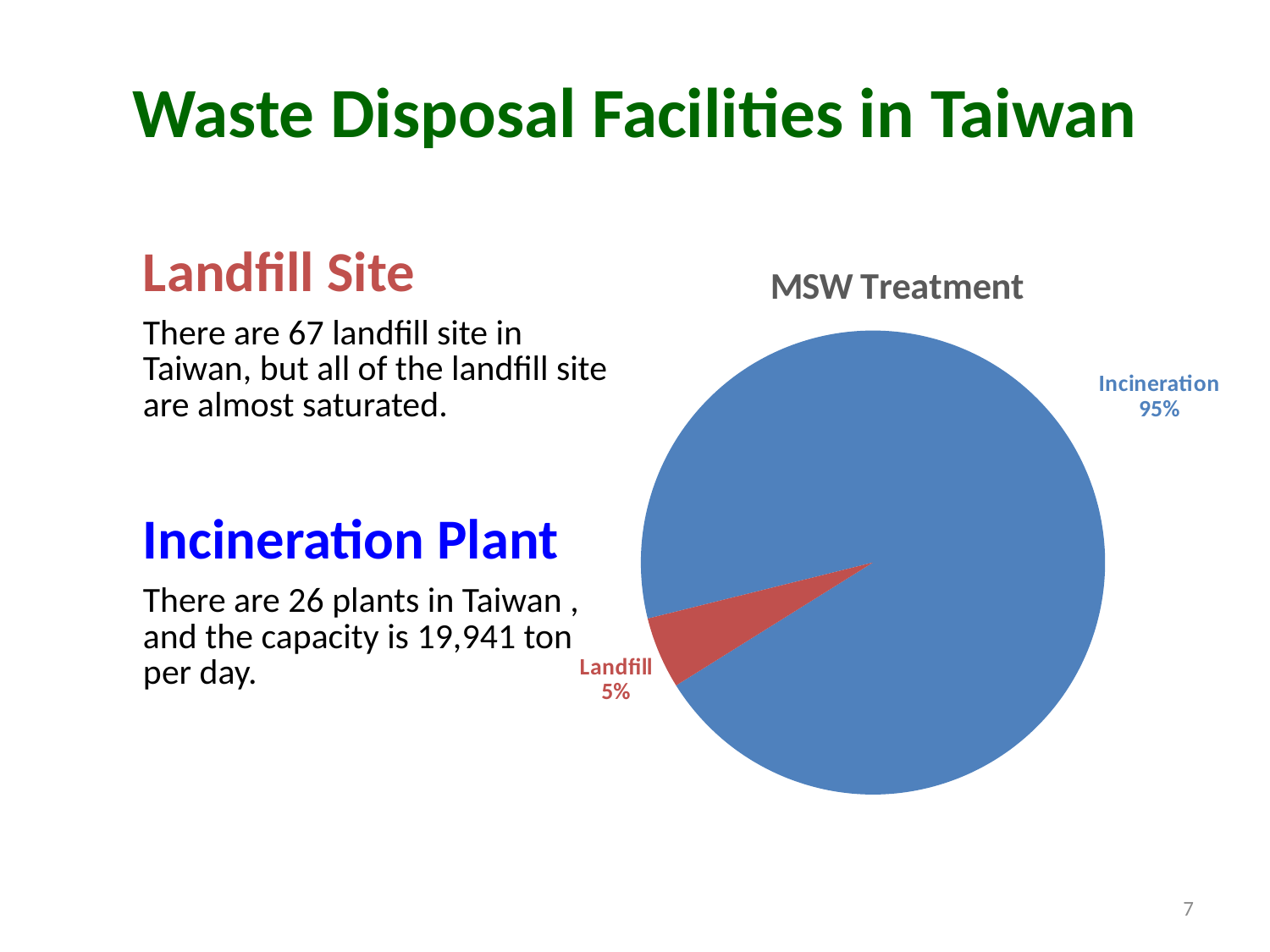
Which category has the smallest slice of the pie? Landfill What share of the pie does Incineration account for? 95% What colour is the Landfill slice? red Which category has the largest slice of the pie? Incineration What is the difference in percentage points between the Incineration and Landfill slices? 90% Which is larger, the Incineration slice or the Landfill slice? Incineration How many slices does the pie chart have? 2 What share of the pie does Landfill account for? 5% What is the title of the chart? MSW Treatment What type of chart is shown on the slide? pie chart